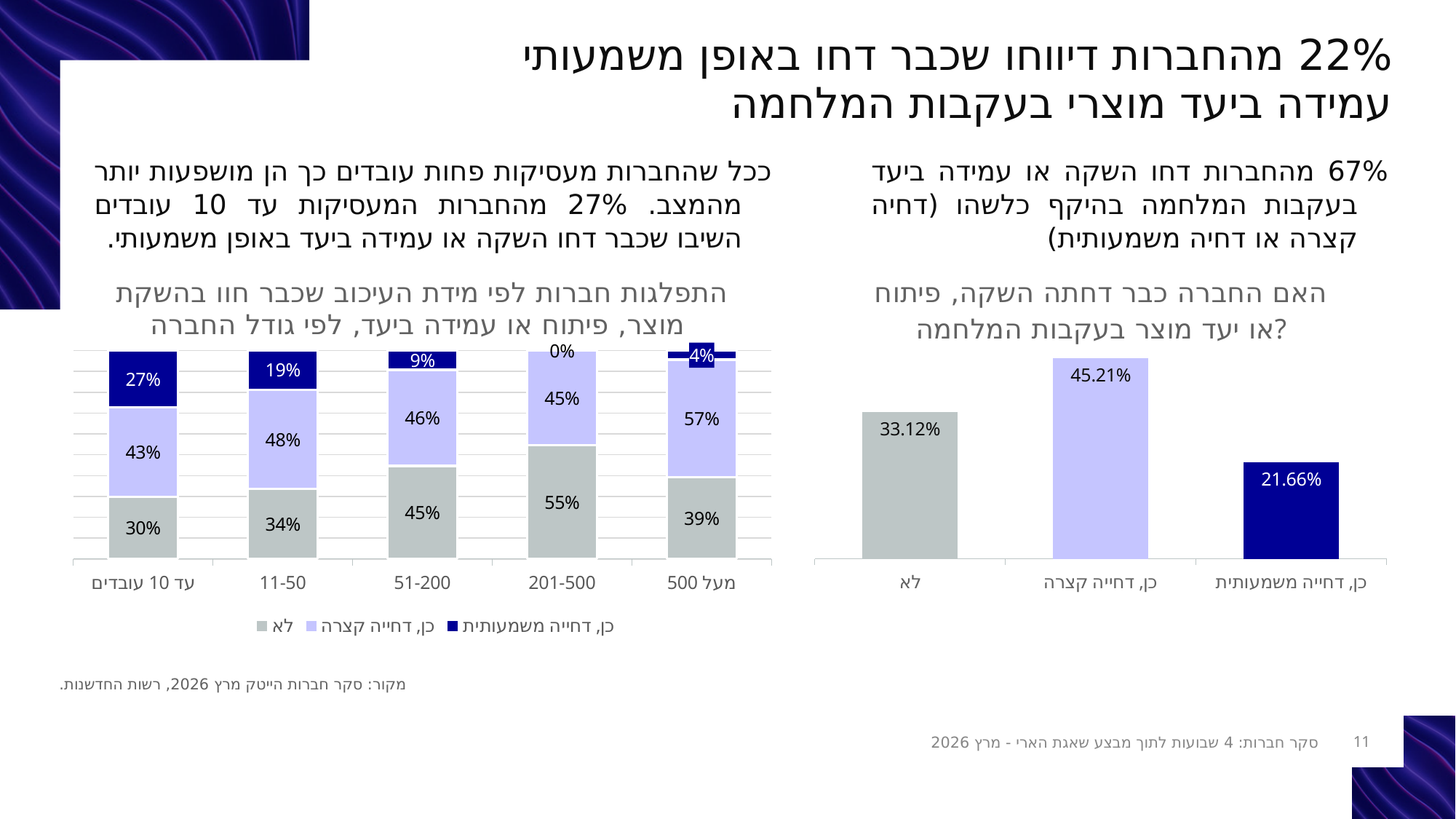
In the left chart (התפלגות חברות לפי מידת העיכוב), which category has the highest 'כן, דחייה קצרה' value? מעל 500 What kind of chart is the left chart (התפלגות חברות לפי מידת העיכוב)? Stacked bar chart In the left chart (התפלגות חברות לפי מידת העיכוב), which is larger: the 'לא' value for '11-50' or for '51-200'? 51-200 In the right chart (האם החברה כבר דחתה השקה, פיתוח או יעד מוצר בעקבות המלחמה?), how many categories are shown? 3 In the right chart (האם החברה כבר דחתה השקה, פיתוח או יעד מוצר בעקבות המלחמה?), which category has the lowest value? כן, דחייה משמעותית In the left chart (התפלגות חברות לפי מידת העיכוב), how many series does the legend list? 3 In the right chart (האם החברה כבר דחתה השקה, פיתוח או יעד מוצר בעקבות המלחמה?), what is the value for 'כן, דחייה קצרה'? 45.21% In the left chart (התפלגות חברות לפי מידת העיכוב), which category has the lowest 'כן, דחייה משמעותית' value? 201-500 In the left chart (התפלגות חברות לפי מידת העיכוב), what is the 'כן, דחייה משמעותית' value for 'עד 10 עובדים'? 27% In the left chart (התפלגות חברות לפי מידת העיכוב), what is the 'לא' value for the '201-500' category? 55% In the left chart (התפלגות חברות לפי מידת העיכוב), what is the difference between the 'כן, דחייה משמעותית' values for '11-50' and '51-200'? 10% In the right chart (האם החברה כבר דחתה השקה, פיתוח או יעד מוצר בעקבות המלחמה?), what is the difference between 'לא' and 'כן, דחייה משמעותית'? 11.46%